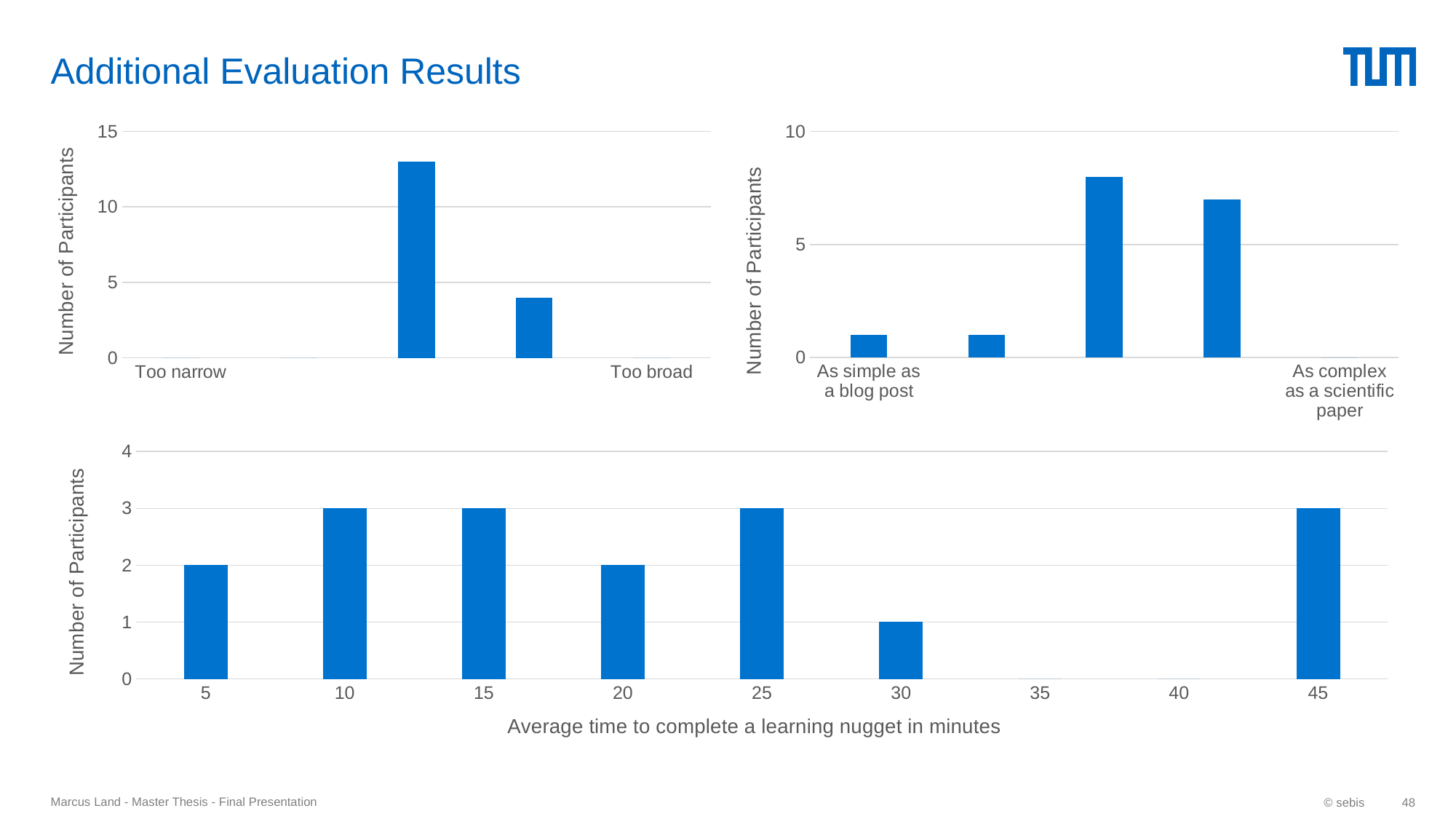
What type of chart is the bottom chart? Bar chart In the bottom chart, which average time has the lowest non-zero number of participants? 30 In the bottom chart, what is the number of participants for an average time of 45 minutes? 3 In the top-left chart, is the value of the shorter bar greater or less than 5? less In the bottom chart, what is the number of participants for an average time of 5 minutes? 2 In the top-left chart, is the value of the tallest bar greater or less than 10? greater In the bottom chart, which has more participants: 10 minutes or 20 minutes? 10 minutes In the bottom chart, what is the number of participants for an average time of 30 minutes? 1 In the top-right chart, how many bars are plotted? 4 In the top-right chart, is the value of the tallest bar greater or less than 5? greater In the bottom chart, how many bars are plotted? 7 In the bottom chart, what is the difference in participants between 15 minutes and 30 minutes? 2